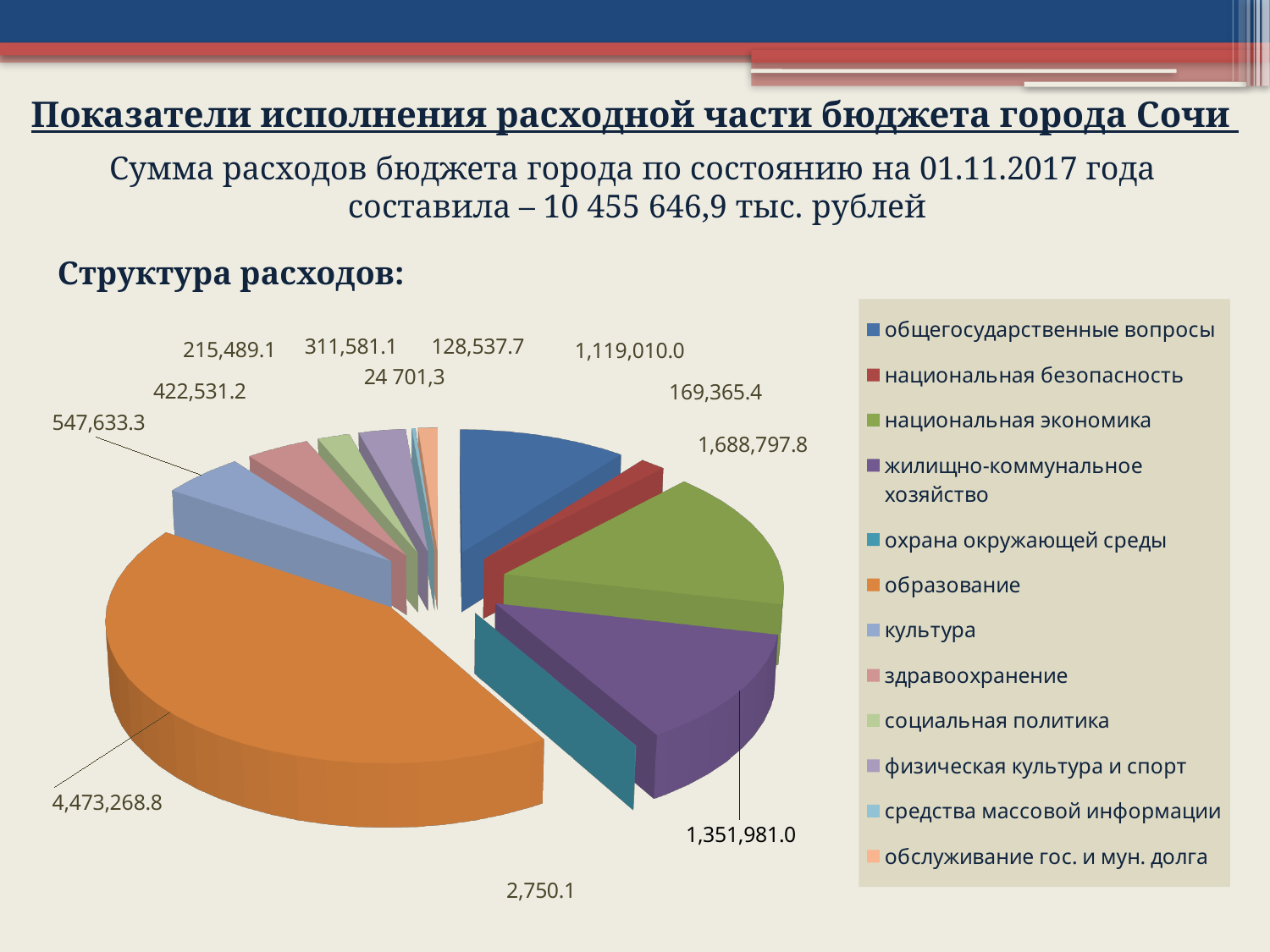
Which is larger in the pie chart: национальная экономика or жилищно-коммунальное хозяйство? национальная экономика What type of chart is used to show the structure of expenditures? Pie chart What colour is the slice for образование in the pie chart? Orange What is the value shown for жилищно-коммунальное хозяйство in the pie chart? 1,351,981.0 What is the value shown for национальная экономика in the pie chart? 1,688,797.8 What is the difference between the values for национальная экономика and жилищно-коммунальное хозяйство? 336,816.8 What is the value shown for охрана окружающей среды in the pie chart? 2,750.1 What is the value shown for образование (education) in the pie chart? 4,473,268.8 Which expenditure category has the largest slice in the pie chart? образование How many expenditure categories does the legend of the pie chart list? 12 What is the value shown for культура in the pie chart? 547,633.3 Which expenditure category has the smallest slice in the pie chart? охрана окружающей среды